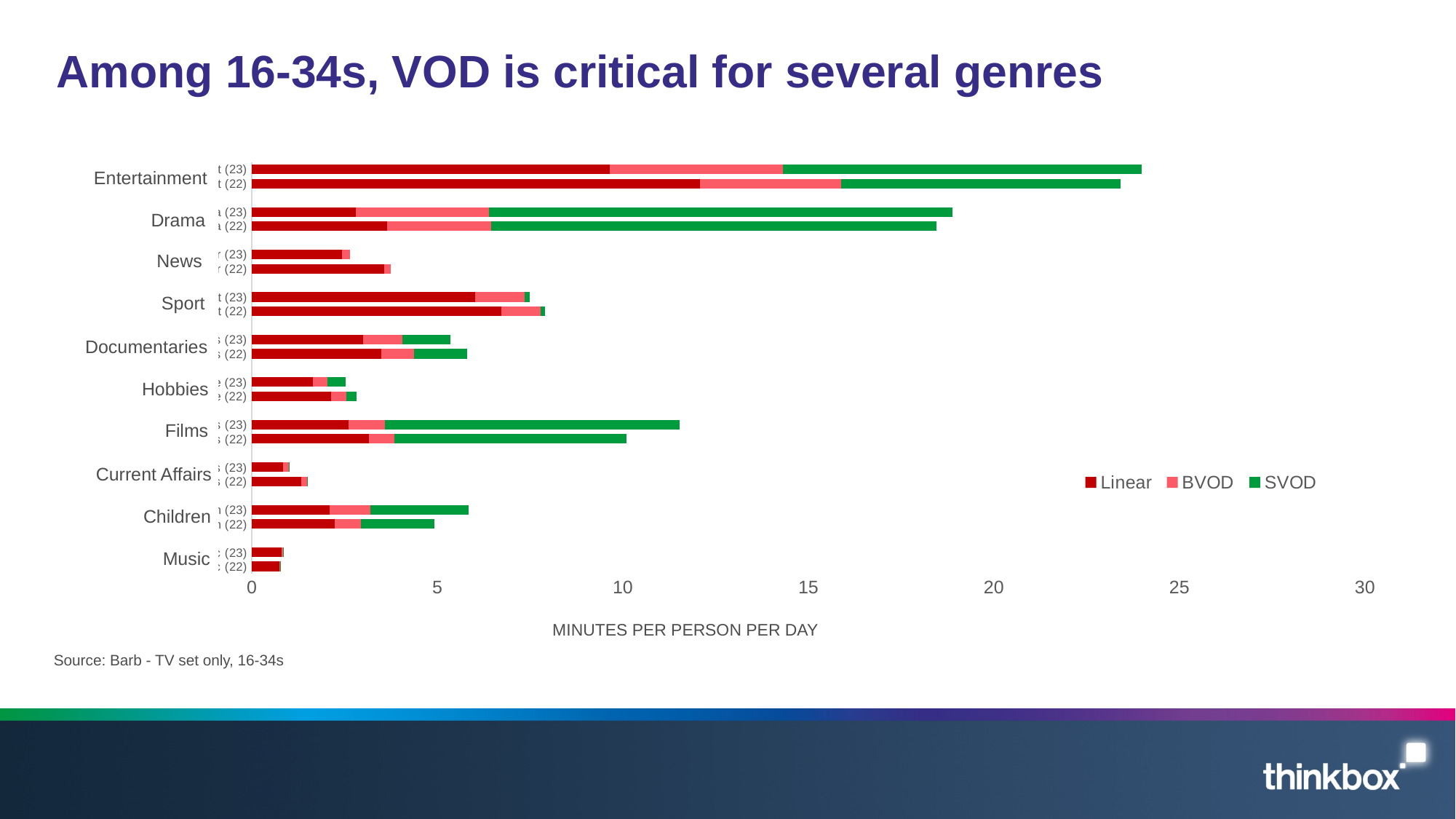
Which has a longer total bar, Films (23) or Sport (23)? Films (23) What is the title of the x axis? MINUTES PER PERSON PER DAY How many genres are shown on the chart? 10 Is the total value for Entertainment (23) greater or less than 20? greater Is the total value for Films (23) greater or less than 10? greater What kind of chart is shown on the slide? bar chart Which series is shown in green in the legend? SVOD Is the total value for Drama (23) greater or less than 20? less How many series does the legend list? 3 Which genre has the shortest bars on the chart? Music Which genre has the longest bar on the chart? Entertainment